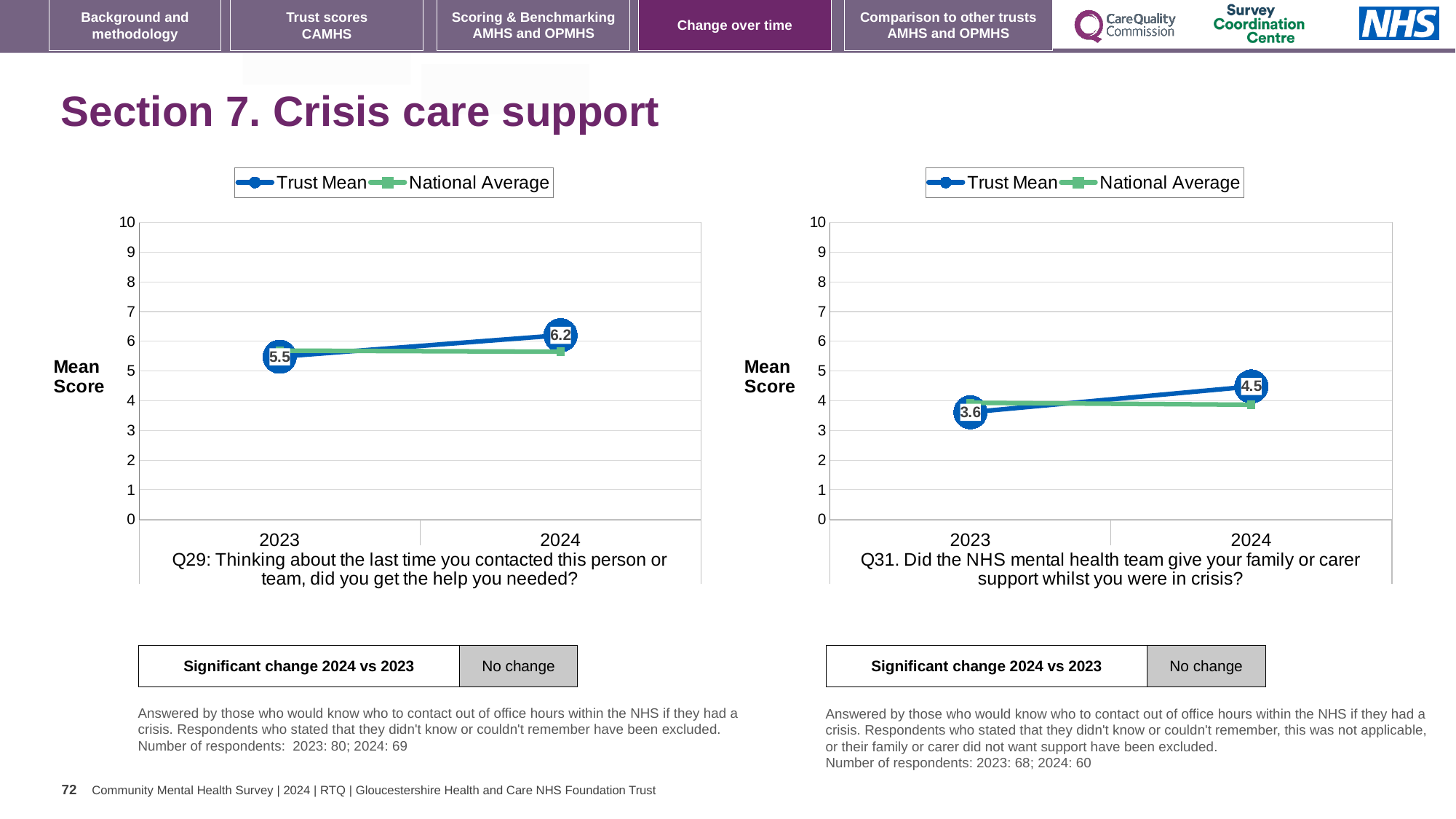
In the Q31 chart (right), what is the Trust Mean score for 2023? 3.6 In the Q29 chart (left), what is the Trust Mean score for 2023? 5.5 In the Q29 chart (left), by how much did the Trust Mean change from 2023 to 2024? 0.7 In the Q31 chart (right), does the Trust Mean rise or fall from 2023 to 2024? rise How many years are plotted on the x axis of the Q29 chart (left)? 2 In the Q29 chart (left), which series has the higher value in 2024, Trust Mean or National Average? Trust Mean In the Q31 chart (right), by how much did the Trust Mean change from 2023 to 2024? 0.9 What type of chart is the Q29 chart on the left? line chart How many series does the legend of the Q31 chart (right) list? 2 In the Q31 chart (right), what is the Trust Mean score for 2024? 4.5 In the Q31 chart (right), is the National Average value for 2023 greater or less than 5? less In the Q29 chart (left), what is the Trust Mean score for 2024? 6.2